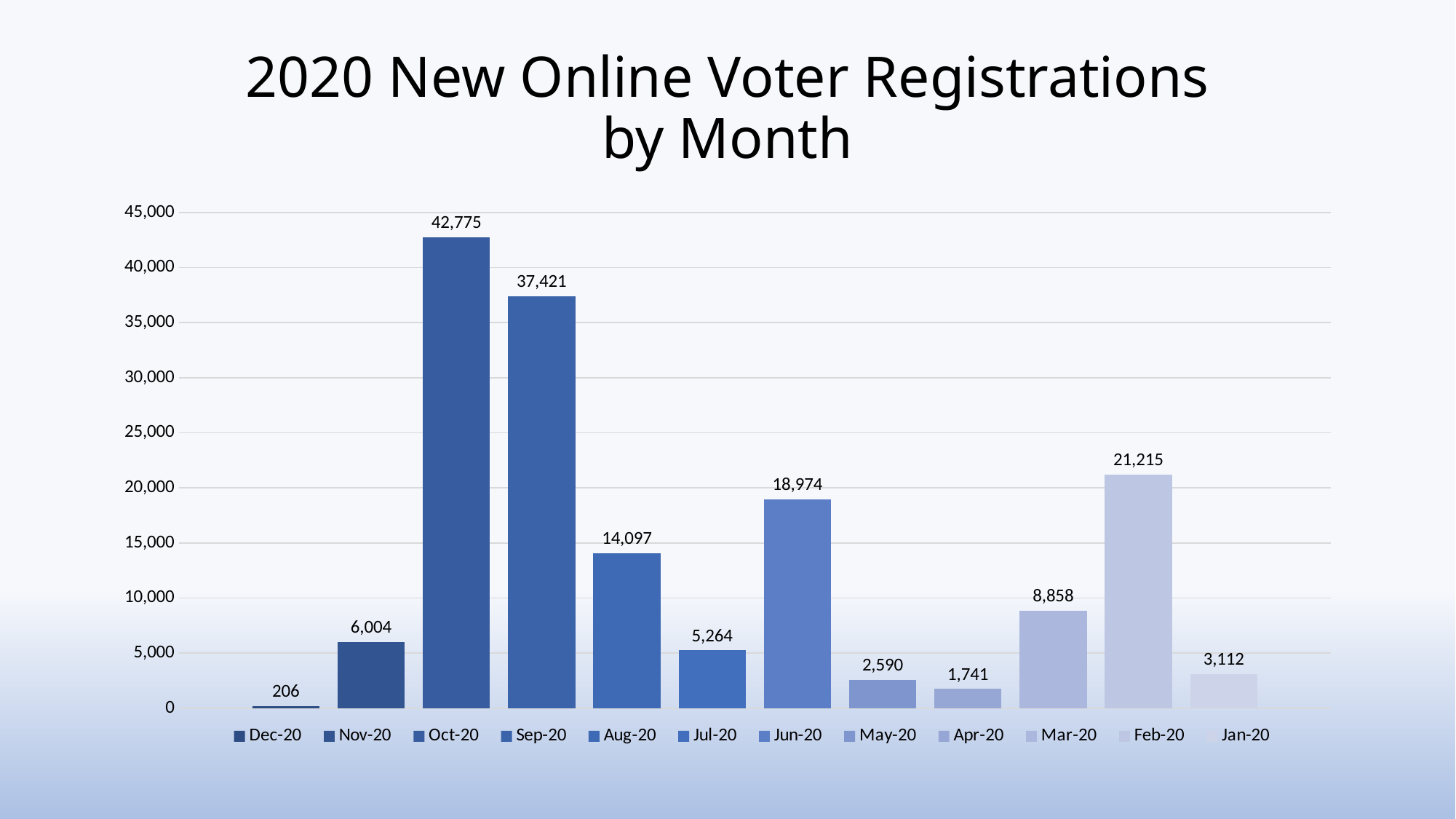
What kind of chart is shown on the slide? bar chart Which is larger, the value for Jun-20 or the value for Aug-20? Jun-20 Is the value for Mar-20 greater or less than 10,000? less What is the value for Oct-20? 42,775 How many bars are plotted on the chart? 12 What is the value for Feb-20? 21,215 What is the value for Dec-20? 206 Which month has the lowest number of new online voter registrations? Dec-20 Which month has the highest number of new online voter registrations? Oct-20 What is the difference between the values for Oct-20 and Sep-20? 5,354 How many entries does the legend list? 12 What is the title of the chart? 2020 New Online Voter Registrations by Month